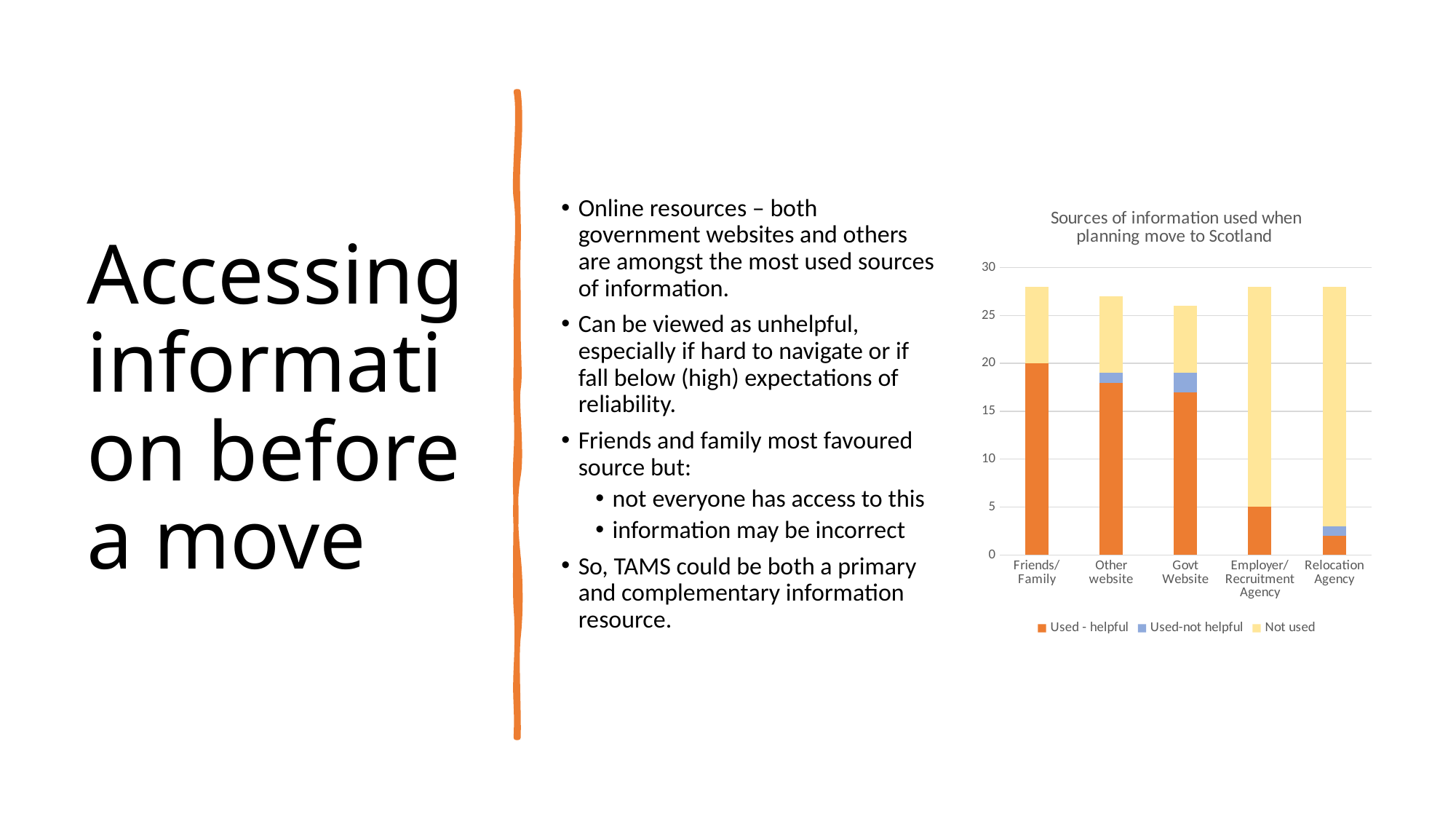
What kind of chart is shown on the slide? Stacked bar chart What is the 'Used - helpful' value for Friends/Family? 20 What is the title of the chart? Sources of information used when planning move to Scotland What is the 'Used - helpful' value for Employer/Recruitment Agency? 5 Which colour represents the 'Not used' series in the chart? Light yellow Which source has the highest 'Used - helpful' value? Friends/Family Which has the larger 'Used - helpful' value, Friends/Family or Employer/Recruitment Agency? Friends/Family Is the 'Used - helpful' value for Govt Website greater or less than 15? greater How many information sources (categories) are shown on the x axis? 5 Is the 'Not used' value for Relocation Agency greater or less than 20? greater How many series does the chart legend list? 3 Which source has the lowest 'Used - helpful' value? Relocation Agency